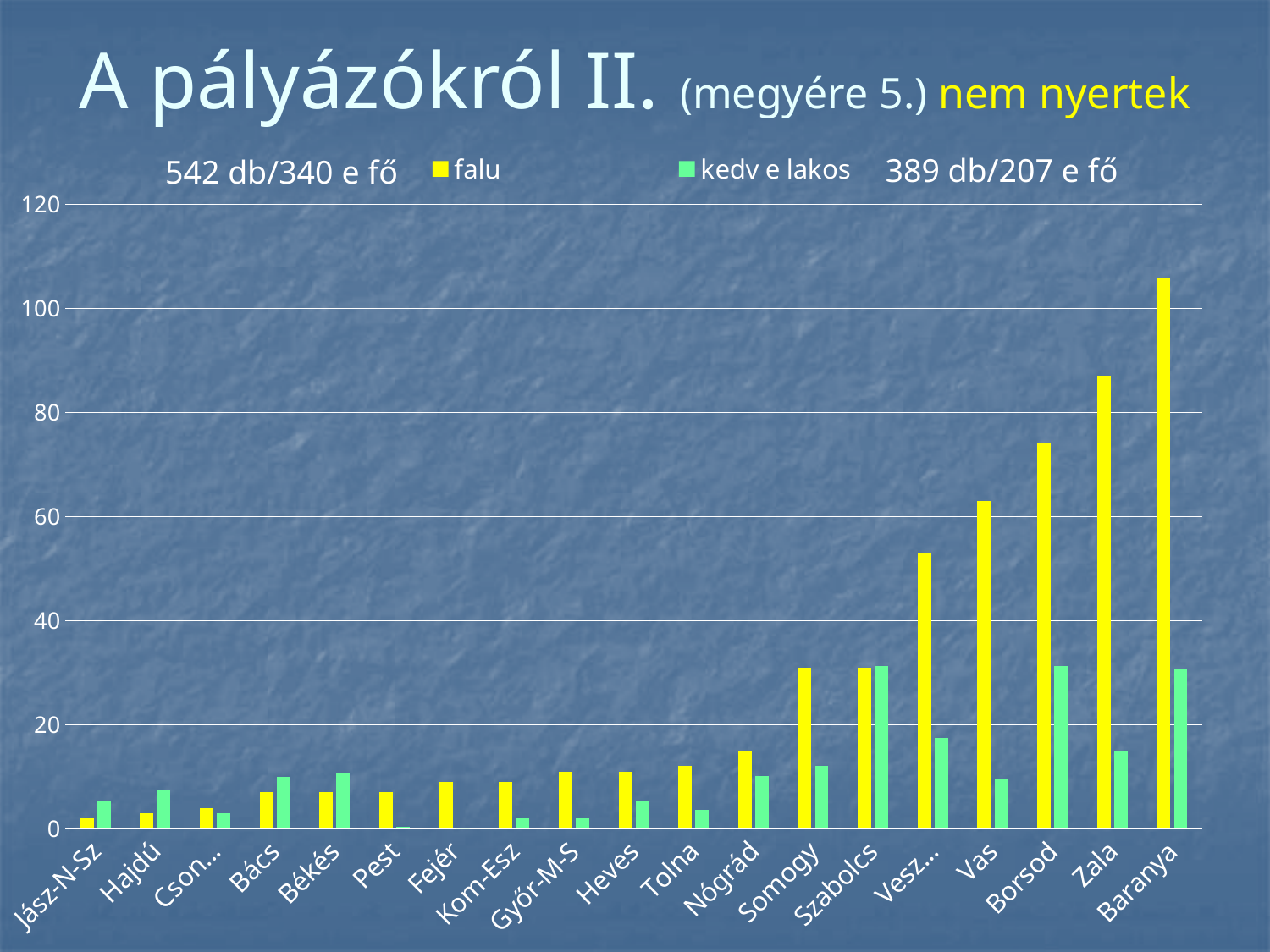
Which is larger, the falu value for Borsod or the falu value for Vas? Borsod Is the kedv e lakos value for Szabolcs greater or less than 20? greater What colour are the bars for the falu series? yellow Which category has the highest value for the falu series? Baranya Do the falu values generally rise or fall from left to right along the x axis? rise How many categories are shown on the x axis? 19 Is the falu value for Borsod greater or less than 80? less Is the falu value for Zala greater or less than 80? greater What kind of chart is shown on the slide? bar chart How many series does the legend list? 2